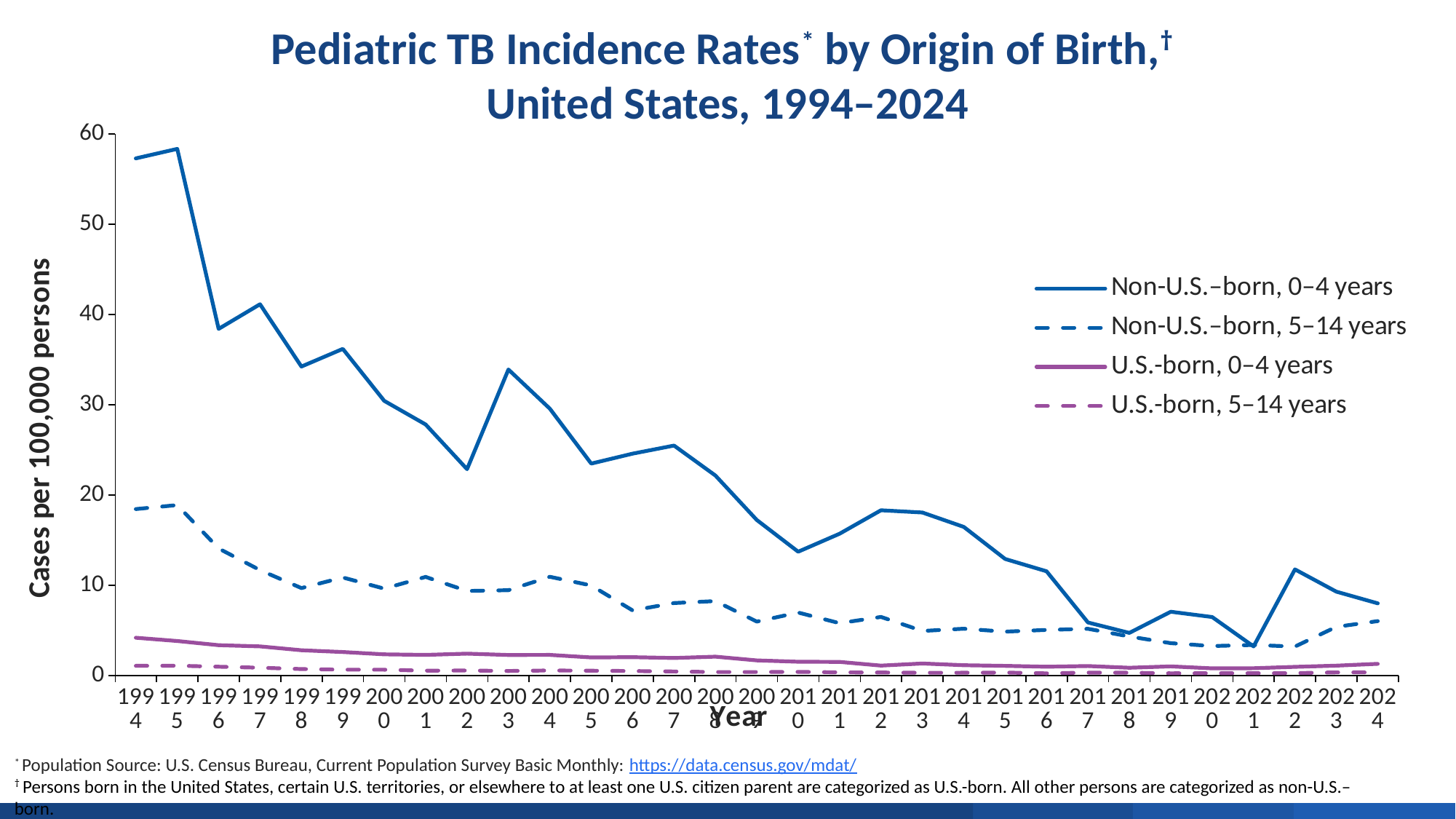
How many series does the legend list? 4 Overall, does the Non-U.S.–born, 0–4 years line rise or fall from 1994 to 2024? Fall How many years are plotted along the x axis? 31 Which series has the lowest values across the chart? U.S.-born, 5–14 years What is the label of the y axis? Cases per 100,000 persons Is the value for Non-U.S.–born, 0–4 years in 2002 greater or less than 20? greater What kind of chart is shown on the slide? Line chart Is the value for Non-U.S.–born, 0–4 years in 2024 greater or less than 10? less In 2000, which is larger: Non-U.S.–born, 5–14 years or U.S.-born, 0–4 years? Non-U.S.–born, 5–14 years Is the value for Non-U.S.–born, 0–4 years in 1994 greater or less than 50? greater Which series has the highest value in 1994? Non-U.S.–born, 0–4 years